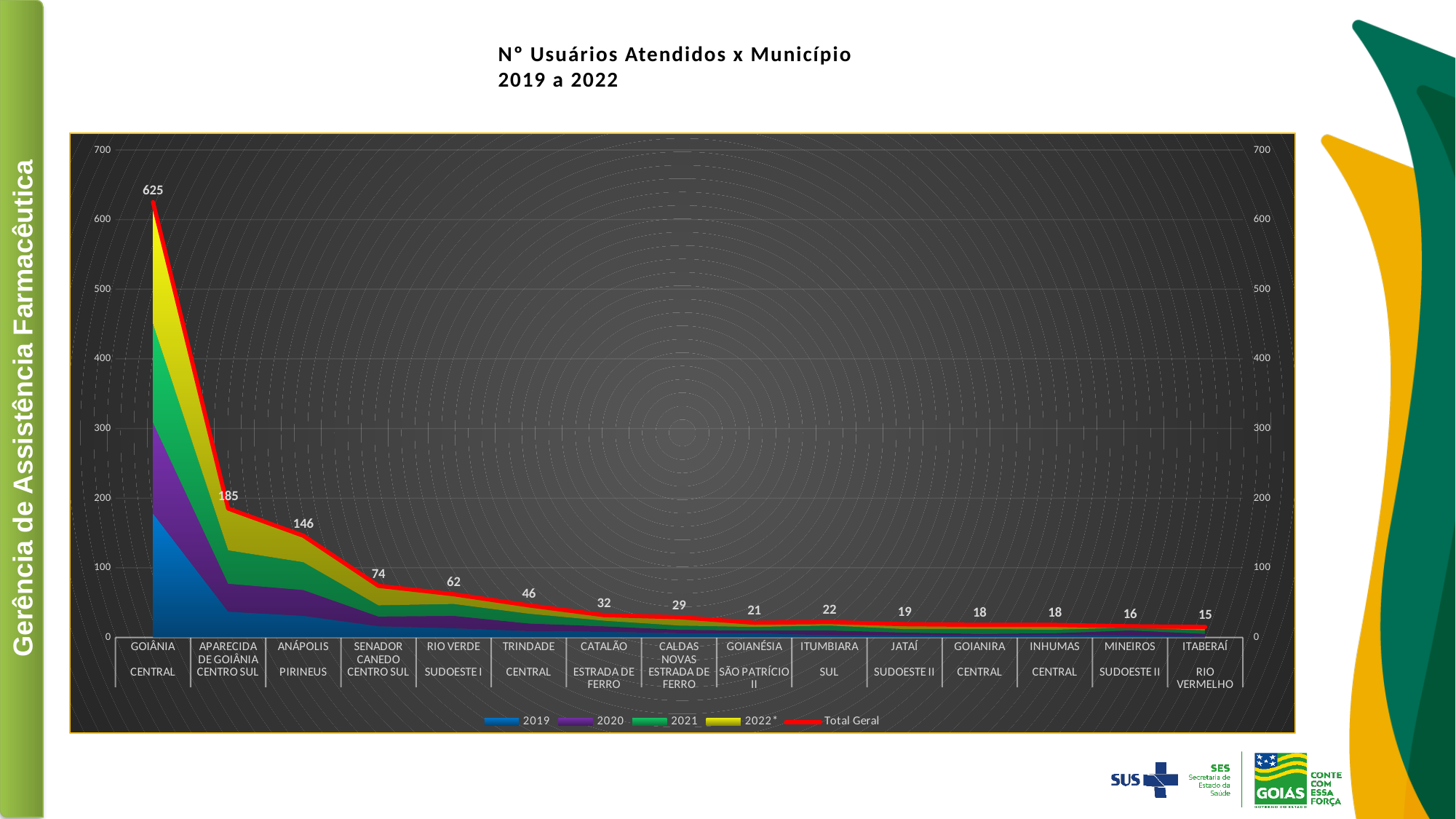
Is the Total Geral value for Aparecida de Goiânia greater or less than 200? less Which municipality has the lowest Total Geral value? Itaberaí What is the Total Geral value for Senador Canedo? 74 What is the Total Geral value for Goiânia? 625 Which has a larger Total Geral value, Rio Verde or Trindade? Rio Verde What is the Total Geral value for Anápolis? 146 How many municipalities are shown on the x axis? 15 What is the Total Geral value for Itumbiara? 22 Which municipality has the highest Total Geral value? Goiânia How many series does the legend list? 5 What is the difference between the Total Geral values for Goiânia and Aparecida de Goiânia? 440 Does the Total Geral line rise or fall from left to right across the municipalities? fall